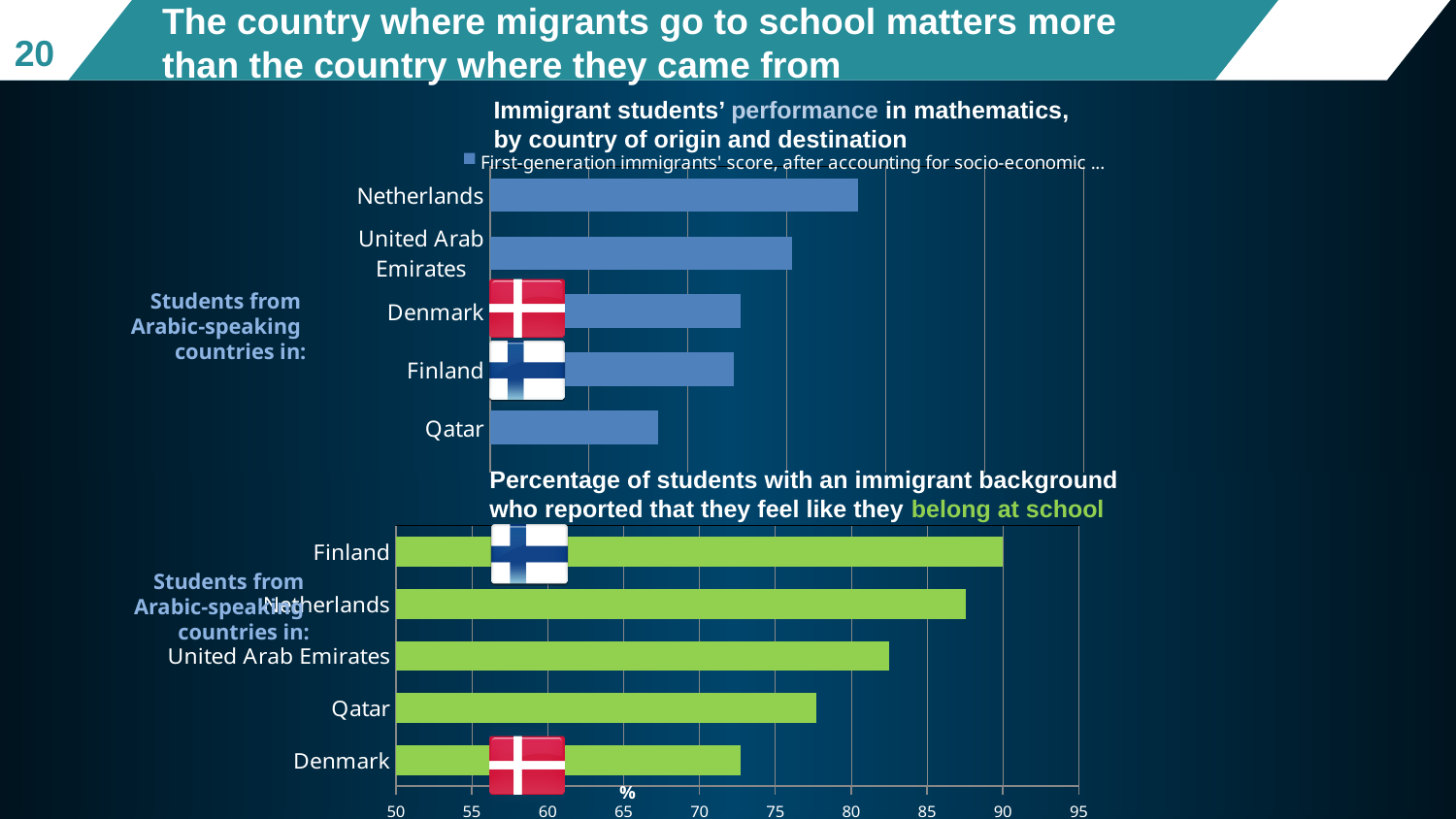
In the bottom chart on students who feel they belong at school, which country has the lowest percentage? Denmark In the top chart on immigrant students' performance in mathematics, which country has the shortest bar? Qatar In the bottom chart on students who feel they belong at school, which country has the highest percentage? Finland In the top chart on immigrant students' performance in mathematics, which has the larger value, United Arab Emirates or Qatar? United Arab Emirates How many countries are shown in the bottom chart on students who feel they belong at school? 5 In the bottom chart on students who feel they belong at school, is the value for Denmark greater or less than 75? less In the bottom chart on students who feel they belong at school, is the value for Qatar greater or less than 80? less In the bottom chart on students who feel they belong at school, which has the larger value, United Arab Emirates or Qatar? United Arab Emirates What type of chart is the top chart on immigrant students' performance in mathematics? Bar chart How many countries are shown in the top chart on immigrant students' performance in mathematics? 5 In the bottom chart on students who feel they belong at school, is the value for Netherlands greater or less than 85? greater In the top chart on immigrant students' performance in mathematics, which country has the longest bar? Netherlands